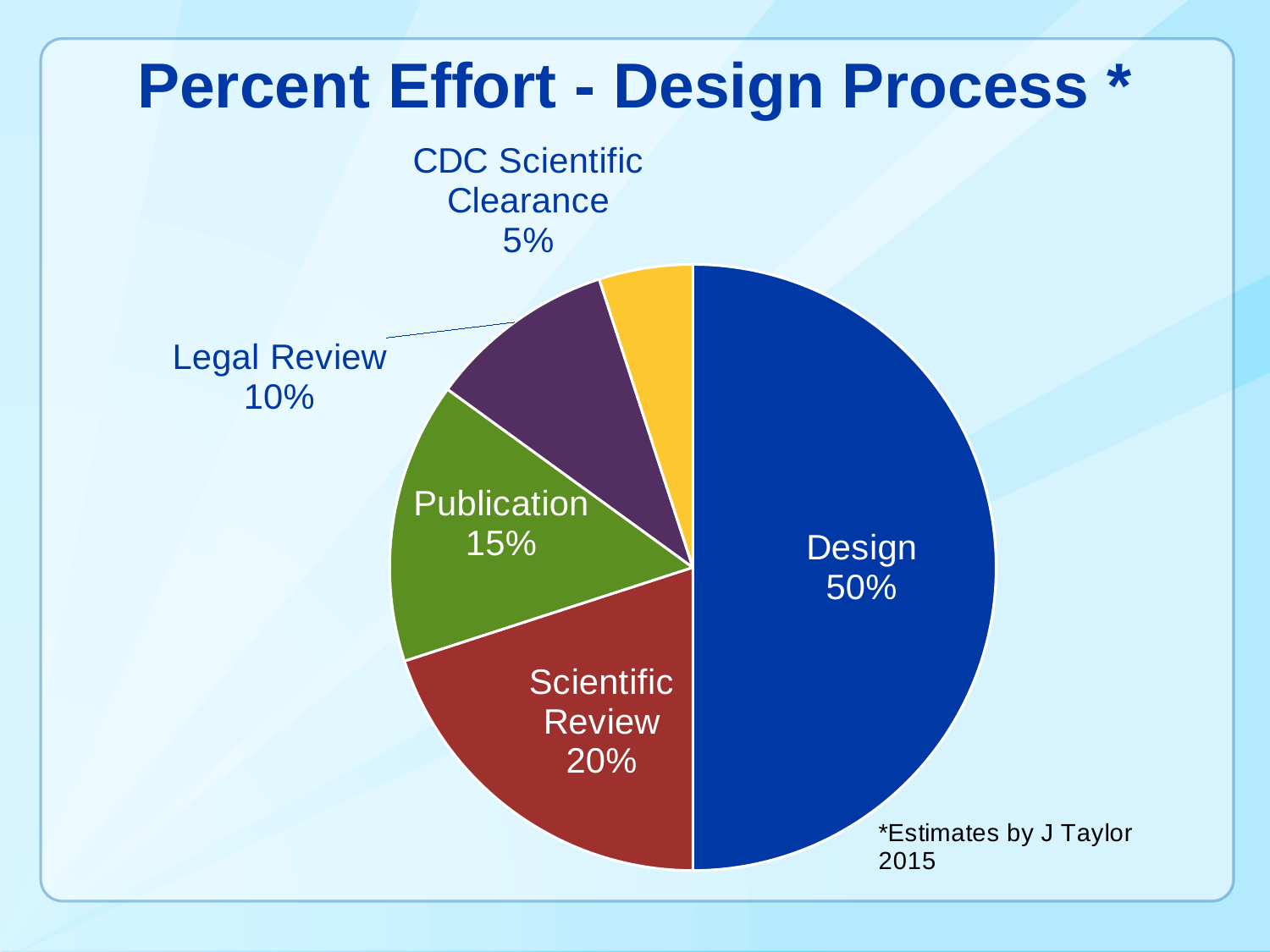
What percentage of effort is attributed to Publication? 15% What is the difference in percent effort between Design and Scientific Review? 30% What is the title of the chart? Percent Effort - Design Process * What percentage of effort is attributed to Legal Review? 10% What percentage of effort is attributed to CDC Scientific Clearance? 5% What percentage of effort is attributed to Design? 50% Which category has the largest share of effort? Design What percentage of effort is attributed to Scientific Review? 20% What kind of chart is shown on the slide? pie chart Which category has the smallest share of effort? CDC Scientific Clearance Which has a larger share of effort, Publication or Legal Review? Publication How many categories are shown in the pie chart? 5